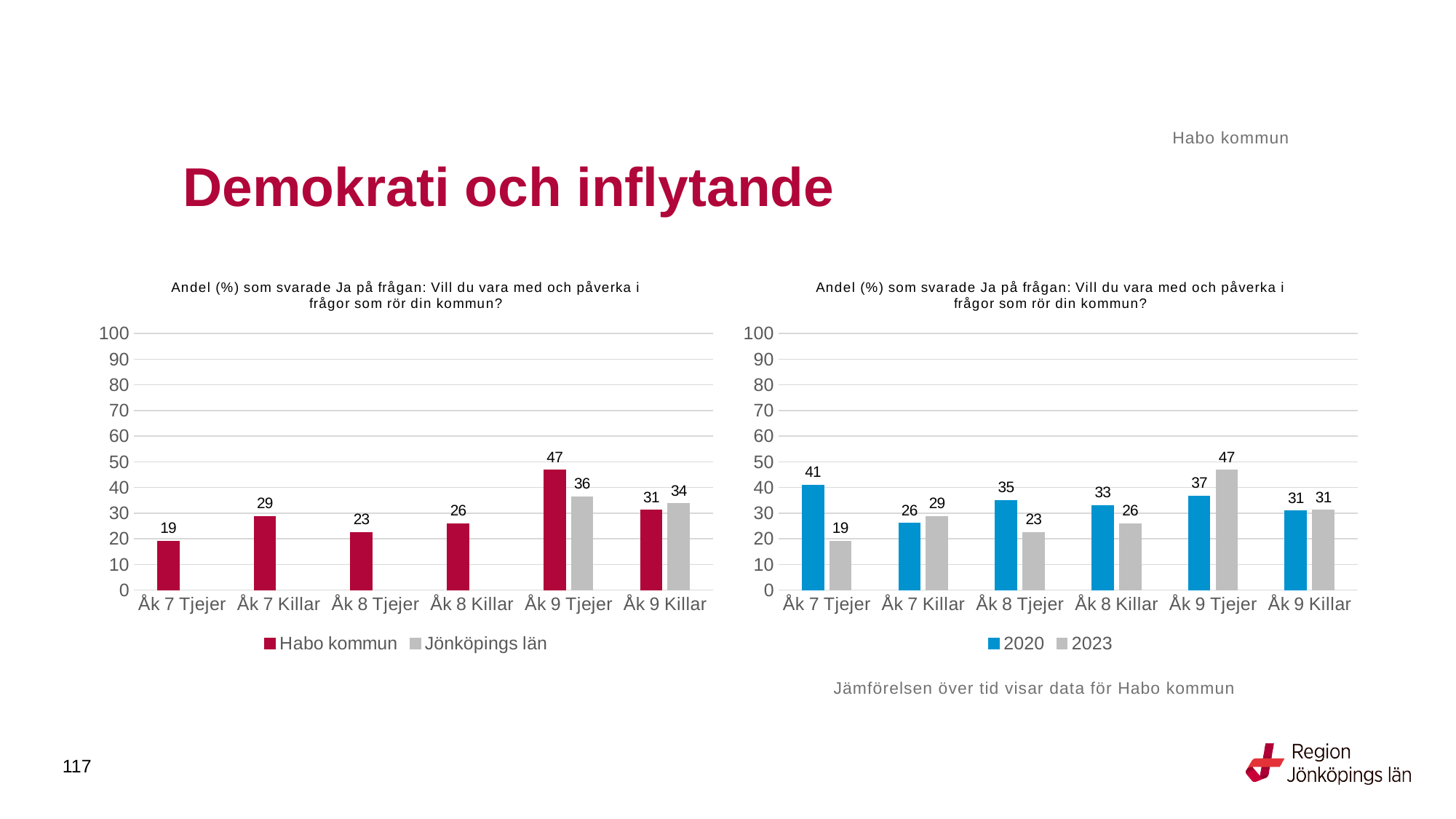
In the right chart, what is the value for 2023 for Åk 8 Killar? 26 In the right chart, which is larger for Åk 8 Tjejer, 2020 or 2023? 2020 In the right chart, what is the value for 2020 for Åk 7 Tjejer? 41 In the left chart, how many series does the legend list? 2 What kind of chart is the right chart? Bar chart In the right chart, which category has the highest value for 2023? Åk 9 Tjejer In the right chart, how many categories are shown on the x axis? 6 In the right chart, what is the difference between 2020 and 2023 for Åk 7 Tjejer? 22 In the left chart, what is the value for Jönköpings län for Åk 9 Killar? 34 In the left chart, what is the difference between Habo kommun and Jönköpings län for Åk 9 Tjejer? 11 In the left chart, what is the value for Habo kommun for Åk 9 Tjejer? 47 In the left chart, which category has the lowest value for Habo kommun? Åk 7 Tjejer